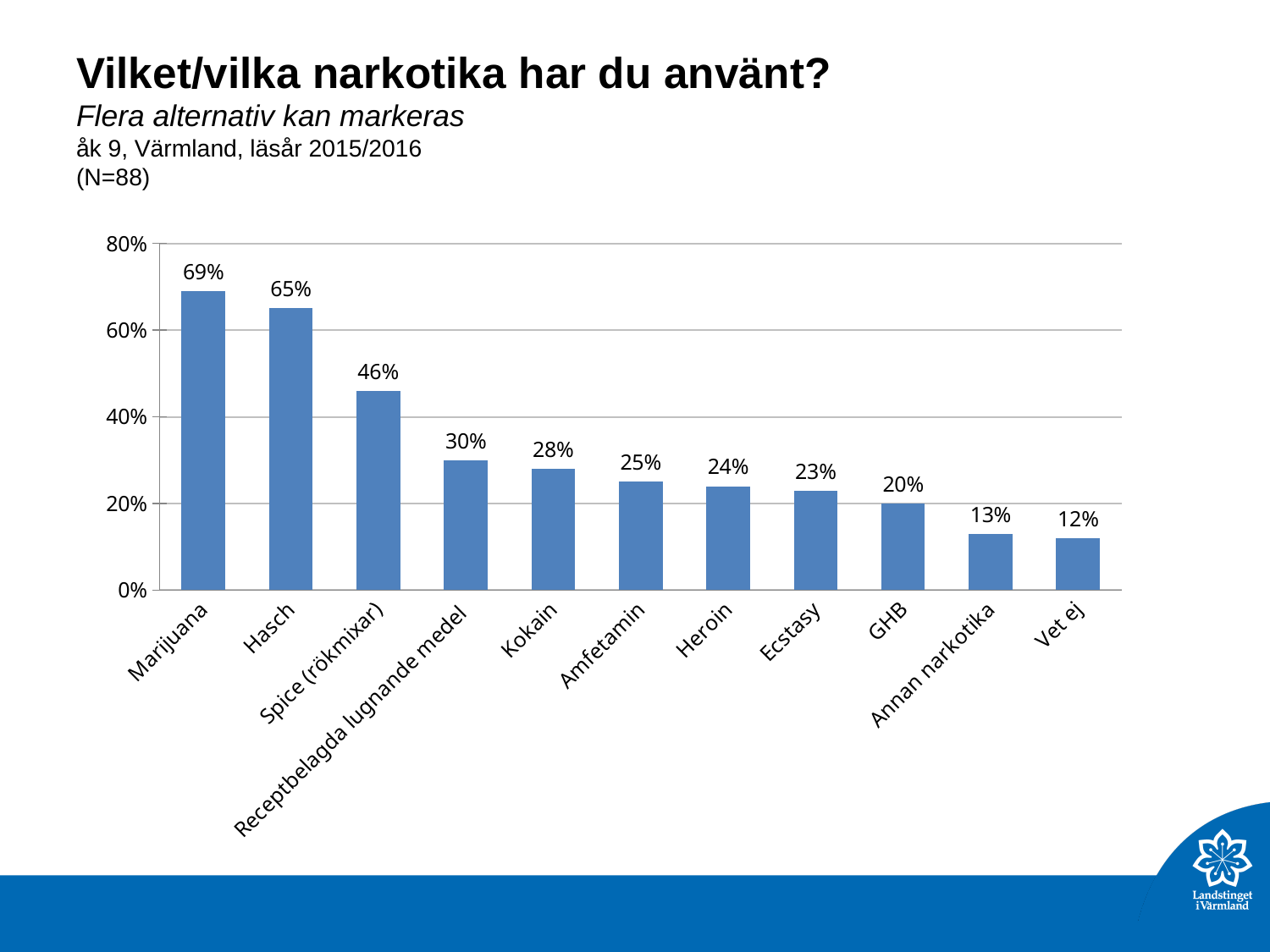
What is the value for Marijuana? 69% Which category has the highest value? Marijuana What is the difference between the values for Spice (rökmixar) and Kokain? 18% Which category has the lowest value? Vet ej How many categories are shown on the x axis? 11 What is the value for GHB? 20% Which is larger, the value for Heroin or the value for Ecstasy? Heroin What is the value for Receptbelagda lugnande medel? 30% Do the values rise or fall from left to right along the x axis? Fall What kind of chart is shown on the slide? Bar chart What is the difference between the values for Marijuana and Hasch? 4% What is the value for Spice (rökmixar)? 46%